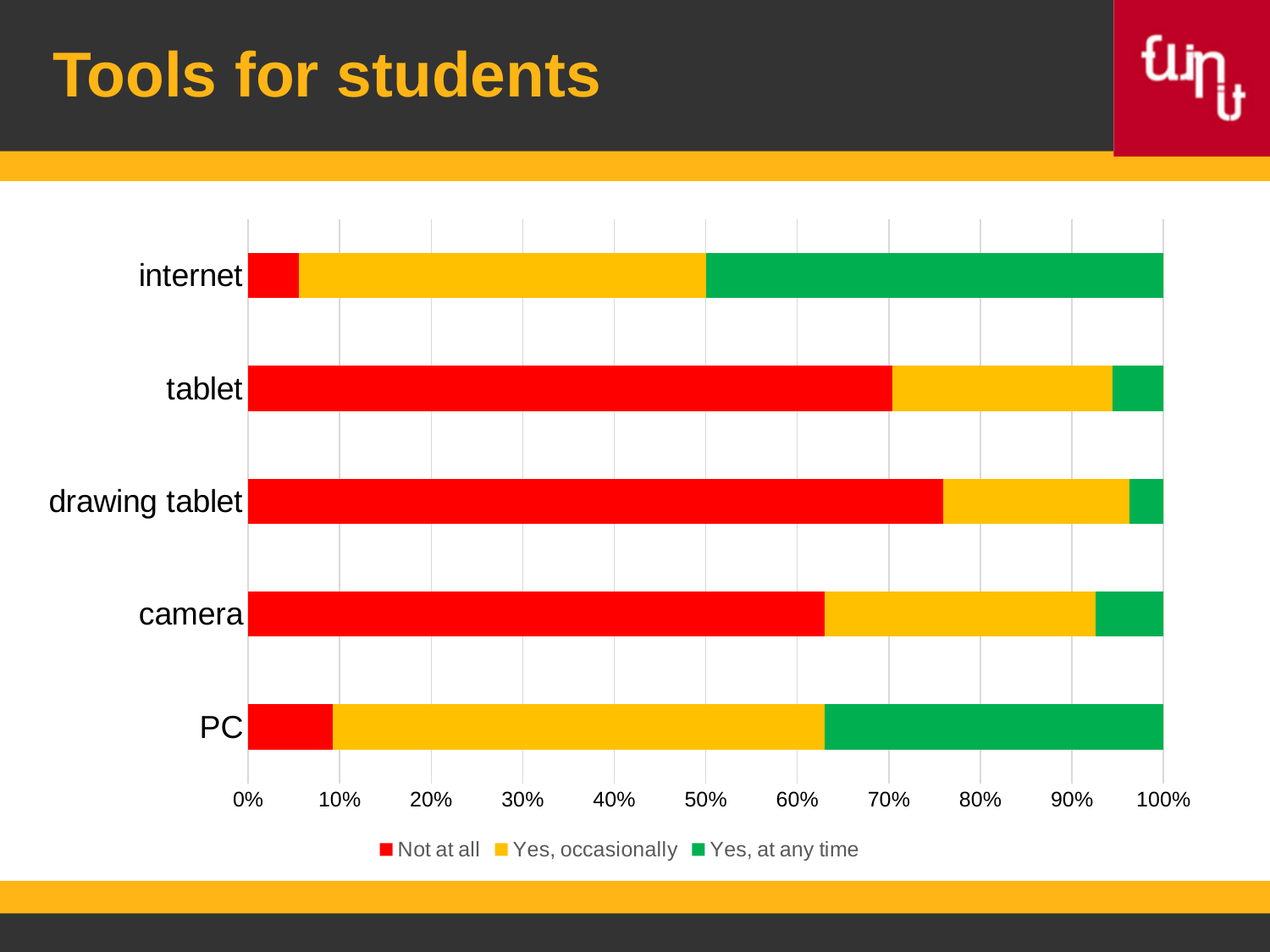
Is the 'Not at all' value for camera greater or less than 70%? less Which tool has the largest 'Not at all' share? drawing tablet Which tool has the largest 'Yes, at any time' share? internet How many tools (categories) are listed on the chart? 5 Which has a larger 'Yes, at any time' share, PC or camera? PC Is the 'Not at all' value for tablet greater or less than 60%? greater How many series does the legend list? 3 Is the 'Not at all' value for PC greater or less than 20%? less Which has a larger 'Not at all' share, tablet or camera? tablet What kind of chart is shown on the slide? Stacked bar chart What colour represents the 'Not at all' series in the chart? Red Which tool has the smallest 'Not at all' share? internet